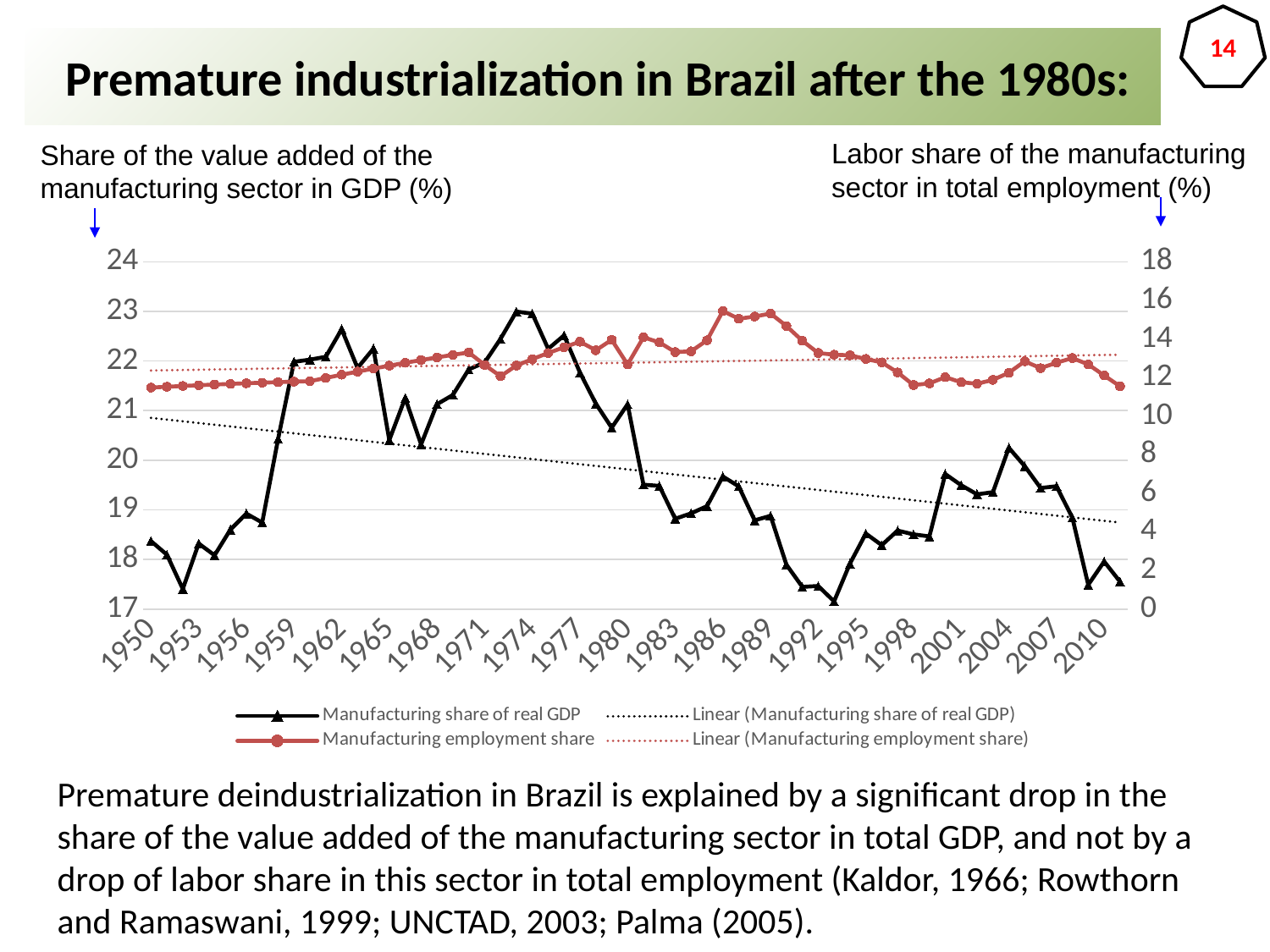
What does the left vertical axis represent according to the label above it? Share of the value added of the manufacturing sector in GDP (%) Is the value for Manufacturing employment share in 1986 greater or less than 14 on the right axis? greater Is the value for Manufacturing employment share in 1950 greater or less than 12 on the right axis? less Is the value for Manufacturing share of real GDP in 1992 greater or less than 18? less What kind of chart is shown on the slide? Line chart Which is larger, the Manufacturing share of real GDP in 1974 or in 1992? 1974 Does the linear trend line for Manufacturing share of real GDP rise or fall from 1950 to 2010? fall How many series does the legend list? 4 Does the linear trend line for Manufacturing employment share rise or fall from 1950 to 2010? rise How many year labels are shown on the x axis? 21